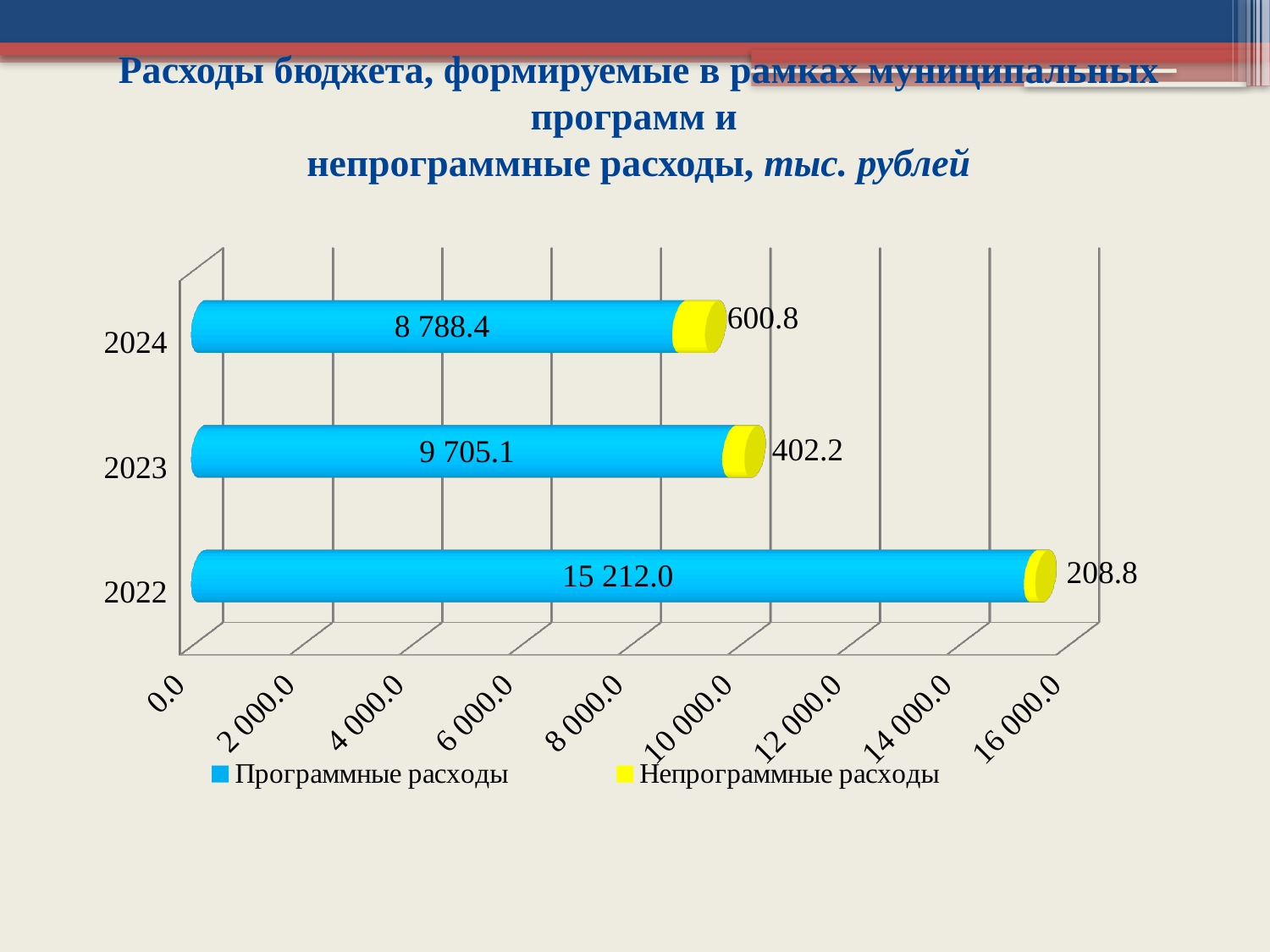
Which is larger: Непрограммные расходы in 2024 or in 2022? 2024 Which year has the highest Программные расходы? 2022 How many years are shown on the chart? 3 What is the difference between Программные расходы in 2022 and 2023? 5 506.9 What is the value of Программные расходы for 2024? 8 788.4 How many series does the legend list? 2 What kind of chart is shown on the slide? Bar chart What is the total of the stacked bar for 2023? 10 107.3 What is the difference between Непрограммные расходы in 2024 and 2023? 198.6 What is the value of Непрограммные расходы for 2023? 402.2 What is the value of Программные расходы for 2022? 15 212.0 Which year has the lowest Непрограммные расходы? 2022